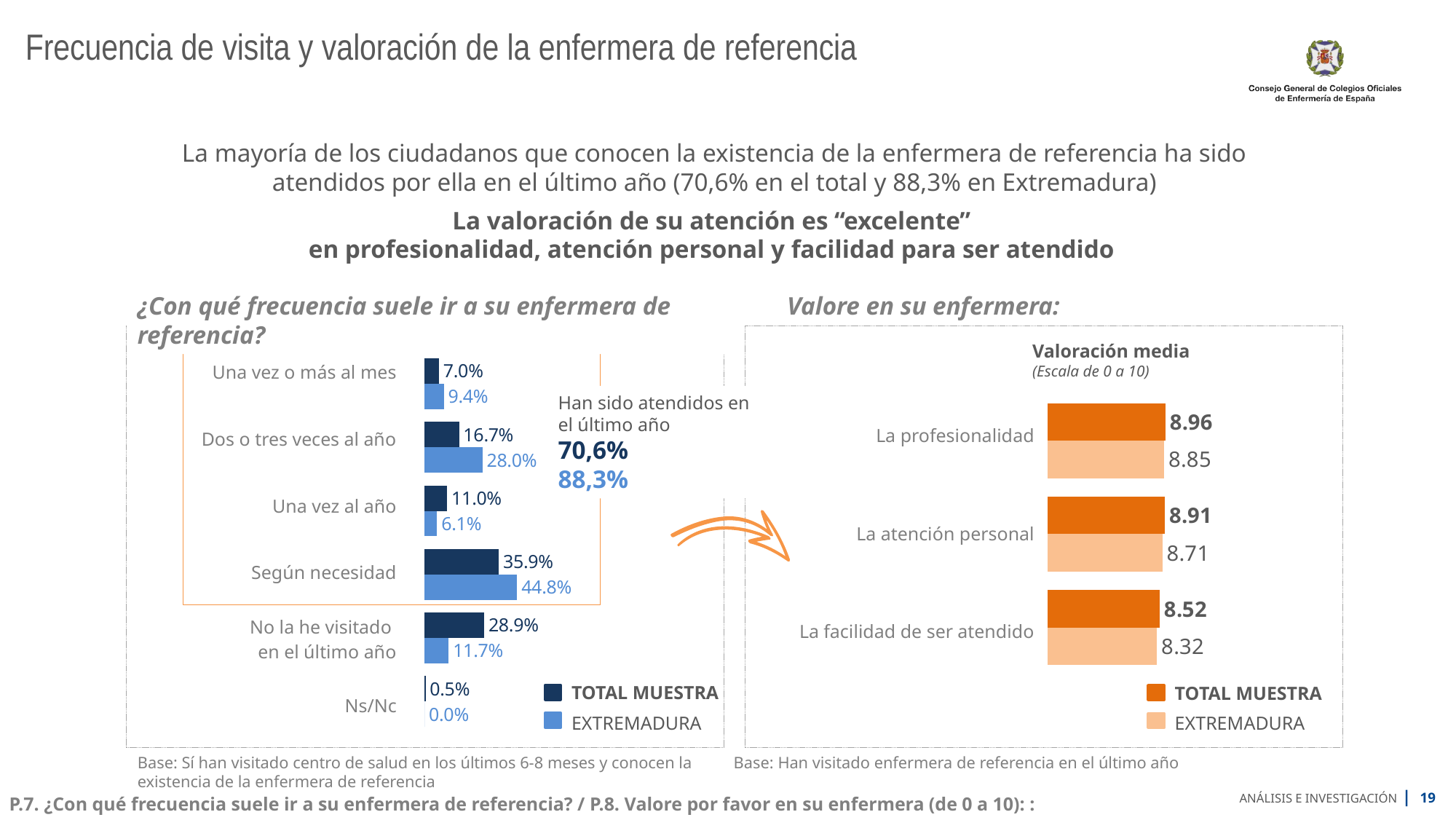
In the right chart (Valore en su enfermera), what is the difference between the TOTAL MUESTRA and EXTREMADURA scores for 'La profesionalidad'? 0.11 In the right chart (Valore en su enfermera), what is the EXTREMADURA score for 'La facilidad de ser atendido'? 8.32 In the right chart (Valore en su enfermera), which aspect has the highest TOTAL MUESTRA score? La profesionalidad In the left chart (¿Con qué frecuencia suele ir a su enfermera de referencia?), which category has the highest EXTREMADURA value? Según necesidad In the left chart (¿Con qué frecuencia suele ir a su enfermera de referencia?), what is the EXTREMADURA value for 'Dos o tres veces al año'? 28.0% In the right chart (Valore en su enfermera), what is the TOTAL MUESTRA score for 'La atención personal'? 8.91 How many categories are shown in the left chart (¿Con qué frecuencia suele ir a su enfermera de referencia?)? 6 In the left chart (¿Con qué frecuencia suele ir a su enfermera de referencia?), which category has the lowest TOTAL MUESTRA value? Ns/Nc In the left chart (¿Con qué frecuencia suele ir a su enfermera de referencia?), what is the difference between the TOTAL MUESTRA and EXTREMADURA values for 'No la he visitado en el último año'? 17.2% In the left chart (¿Con qué frecuencia suele ir a su enfermera de referencia?), which is larger for 'Una vez al año': TOTAL MUESTRA or EXTREMADURA? TOTAL MUESTRA In the left chart (¿Con qué frecuencia suele ir a su enfermera de referencia?), what is the TOTAL MUESTRA value for 'Según necesidad'? 35.9% How many series does the legend of the right chart (Valore en su enfermera) list? 2